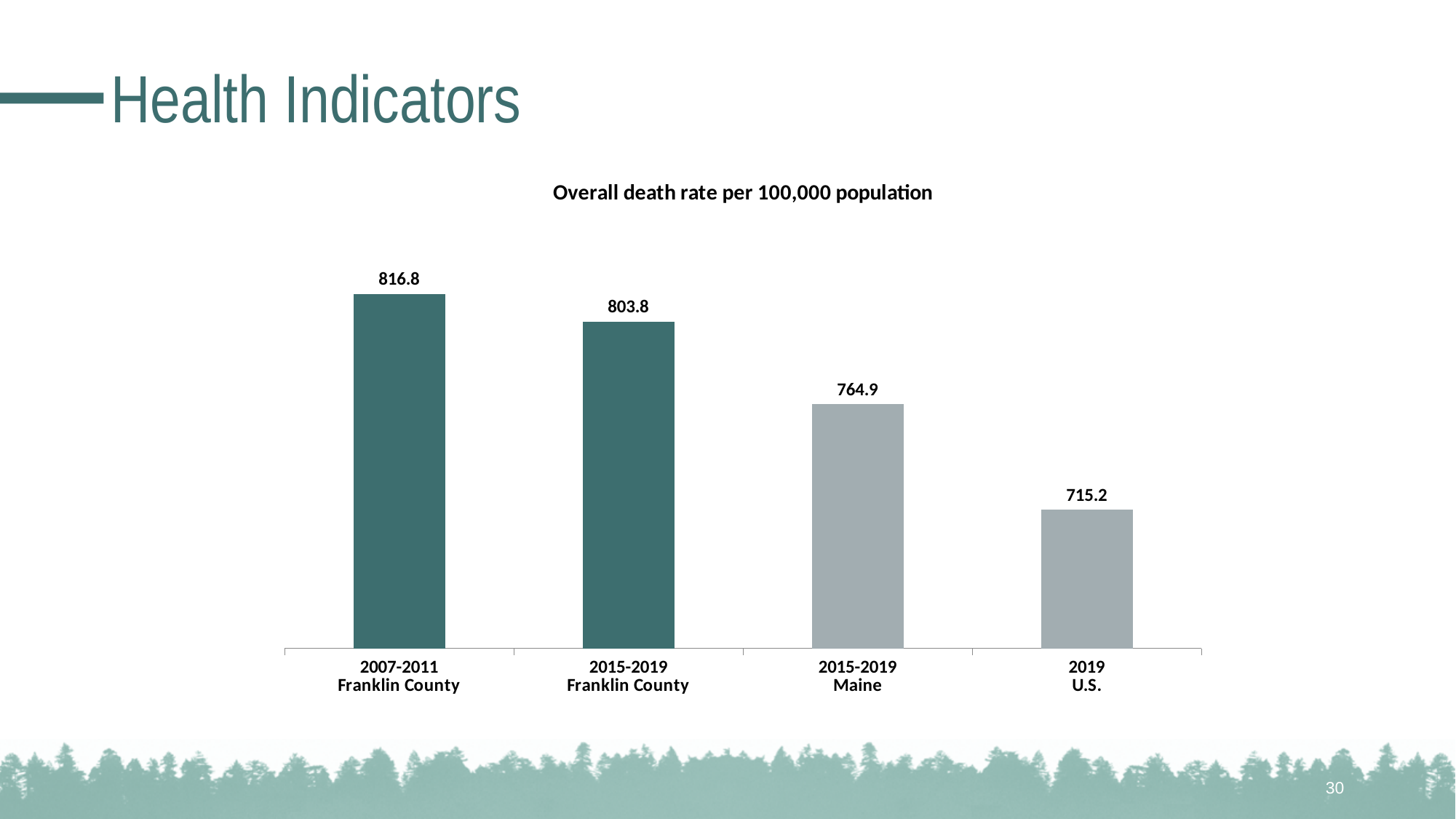
What is the overall death rate per 100,000 population for the U.S. in 2019? 715.2 How many bars are shown in the chart? 4 Which is larger, the 2015-2019 Maine death rate or the 2019 U.S. death rate? 2015-2019 Maine Which category has the highest overall death rate? 2007-2011 Franklin County Which category has the lowest overall death rate? 2019 U.S. What is the difference between the Franklin County death rate in 2007-2011 and in 2015-2019? 13.0 What kind of chart is shown on the slide? Bar chart What is the difference between the 2015-2019 Franklin County death rate and the 2015-2019 Maine death rate? 38.9 What is the title of the chart? Overall death rate per 100,000 population What is the overall death rate per 100,000 population for Franklin County in 2015-2019? 803.8 What is the overall death rate per 100,000 population for Maine in 2015-2019? 764.9 What is the overall death rate per 100,000 population for Franklin County in 2007-2011? 816.8